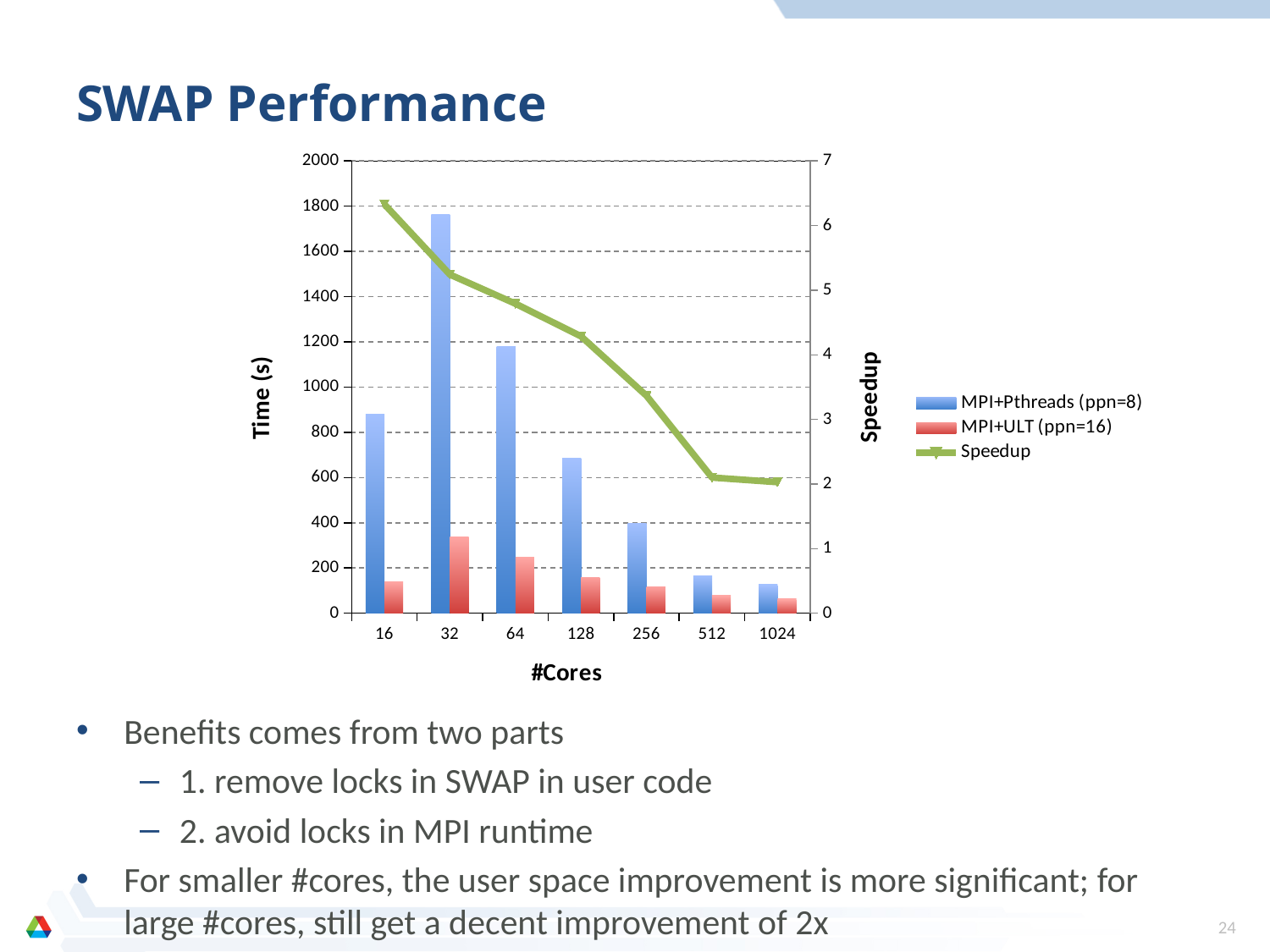
Is the Speedup at 16 cores greater or less than 6? greater At 64 cores, which series has the larger time: MPI+Pthreads (ppn=8) or MPI+ULT (ppn=16)? MPI+Pthreads (ppn=8) Is the MPI+ULT (ppn=16) time at 32 cores greater or less than 400 s? less Does the Speedup line rise or fall as #Cores increases? fall What kind of chart is shown on the slide? A bar chart combined with a line Is the MPI+Pthreads (ppn=8) time at 128 cores greater or less than 600 s? greater How many #Cores categories are shown on the x axis? 7 How many series does the legend list? 3 At which #Cores value is the MPI+ULT (ppn=16) time highest? 32 At which #Cores value is the MPI+Pthreads (ppn=8) time lowest? 1024 At which #Cores value is the MPI+Pthreads (ppn=8) time highest? 32